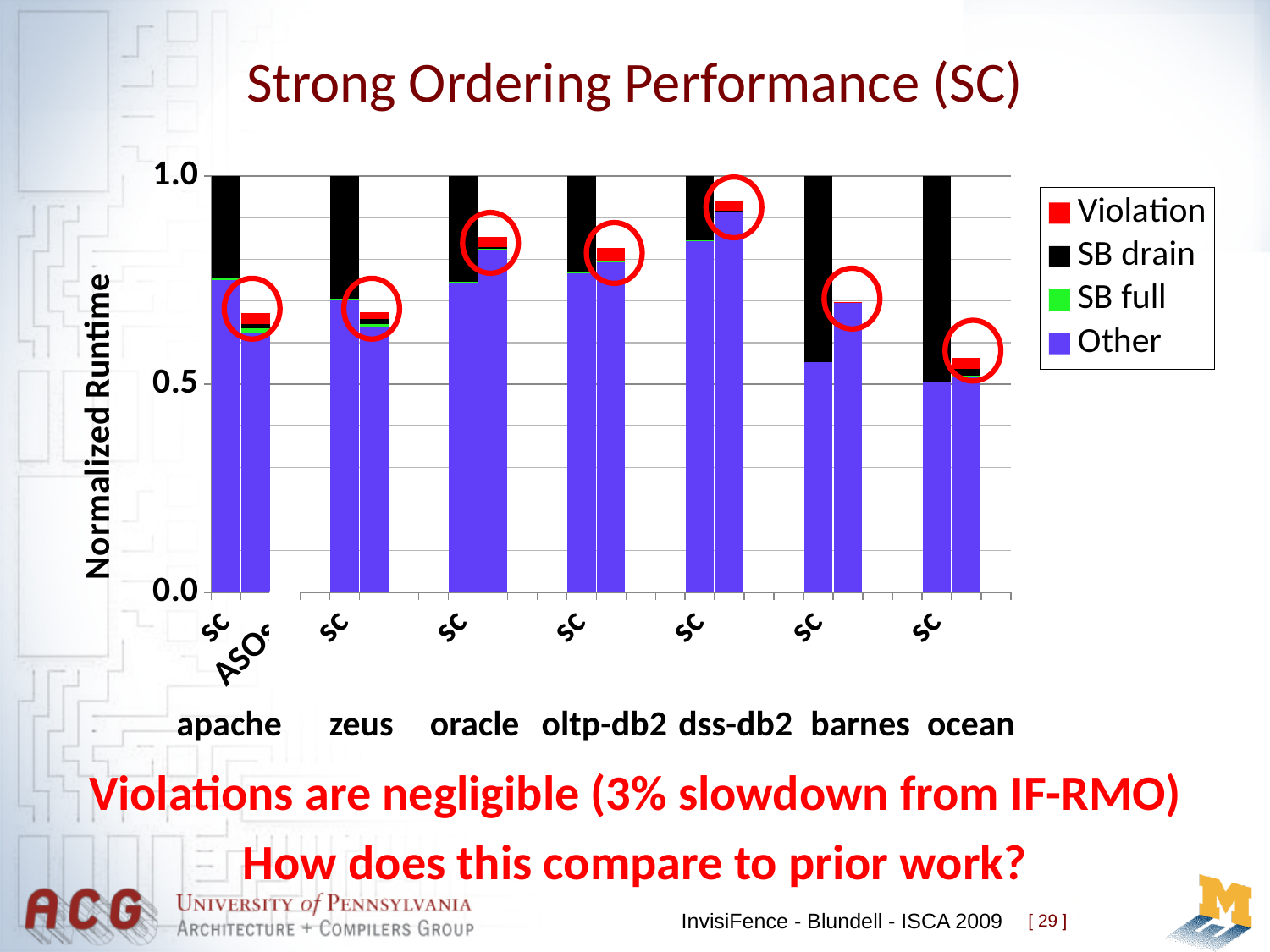
How many series does the legend list? 4 What is the label of the y axis? Normalized Runtime Which benchmark has the tallest second (ASO) bar? dss-db2 Is the total height of the second (ASO) bar for ocean greater or less than 0.5? greater Which is taller, the second (ASO) bar for oracle or the second (ASO) bar for ocean? oracle Is the 'Other' segment of the SC bar for dss-db2 greater or less than 0.5? greater Which benchmark has the shortest second (ASO) bar? ocean Is the total height of the second (ASO) bar for apache greater or less than 1.0? less What is the title of the chart? Strong Ordering Performance (SC) What kind of chart is shown on the slide? Stacked bar chart How many benchmark groups are shown along the x axis? 7